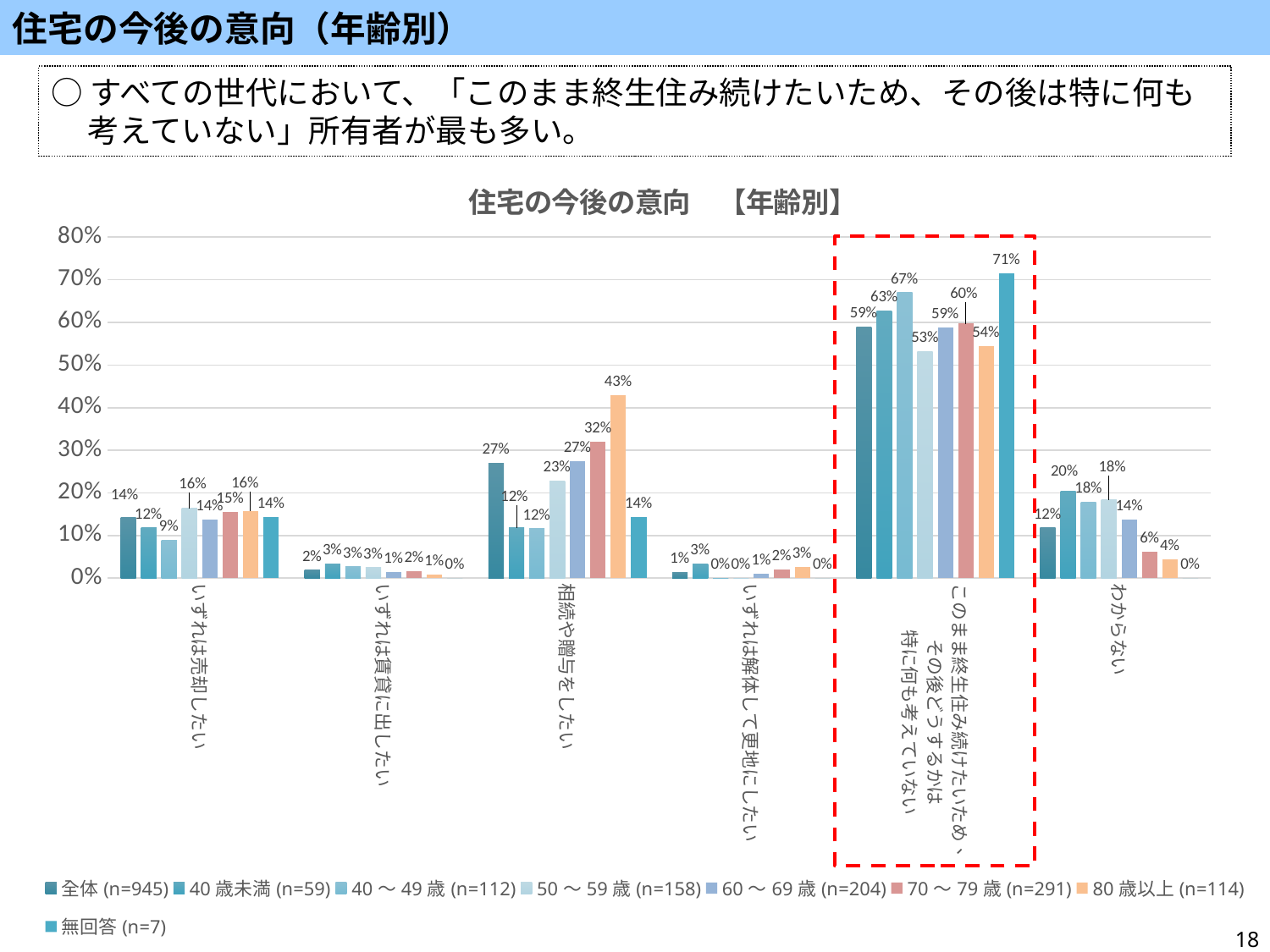
What is the value for 全体 (n=945) in the このまま終生住み続けたいため、その後どうするかは特に何も考えていない category? 59% What kind of chart is shown on the slide? Bar chart In the わからない category, which is larger: the value for 40 歳未満 (n=59) or the value for 70 ～ 79 歳 (n=291)? 40 歳未満 (n=59) What is the value for 40 歳未満 (n=59) in the わからない category? 20% How many categories are shown on the x axis of the chart? 6 Which series has the lowest value in the いずれは売却したい category? 40 ～ 49 歳 (n=112) Which series has the highest value in the このまま終生住み続けたいため、その後どうするかは特に何も考えていない category? 無回答 (n=7) Which category is highlighted with a red dashed box on the chart? このまま終生住み続けたいため、その後どうするかは特に何も考えていない How many series does the legend list? 8 What is the value for 80 歳以上 (n=114) in the 相続や贈与をしたい category? 43% What is the difference between the 80 歳以上 (n=114) value and the 全体 (n=945) value in the 相続や贈与をしたい category? 16% What is the value for 70 ～ 79 歳 (n=291) in the このまま終生住み続けたいため、その後どうするかは特に何も考えていない category? 60%